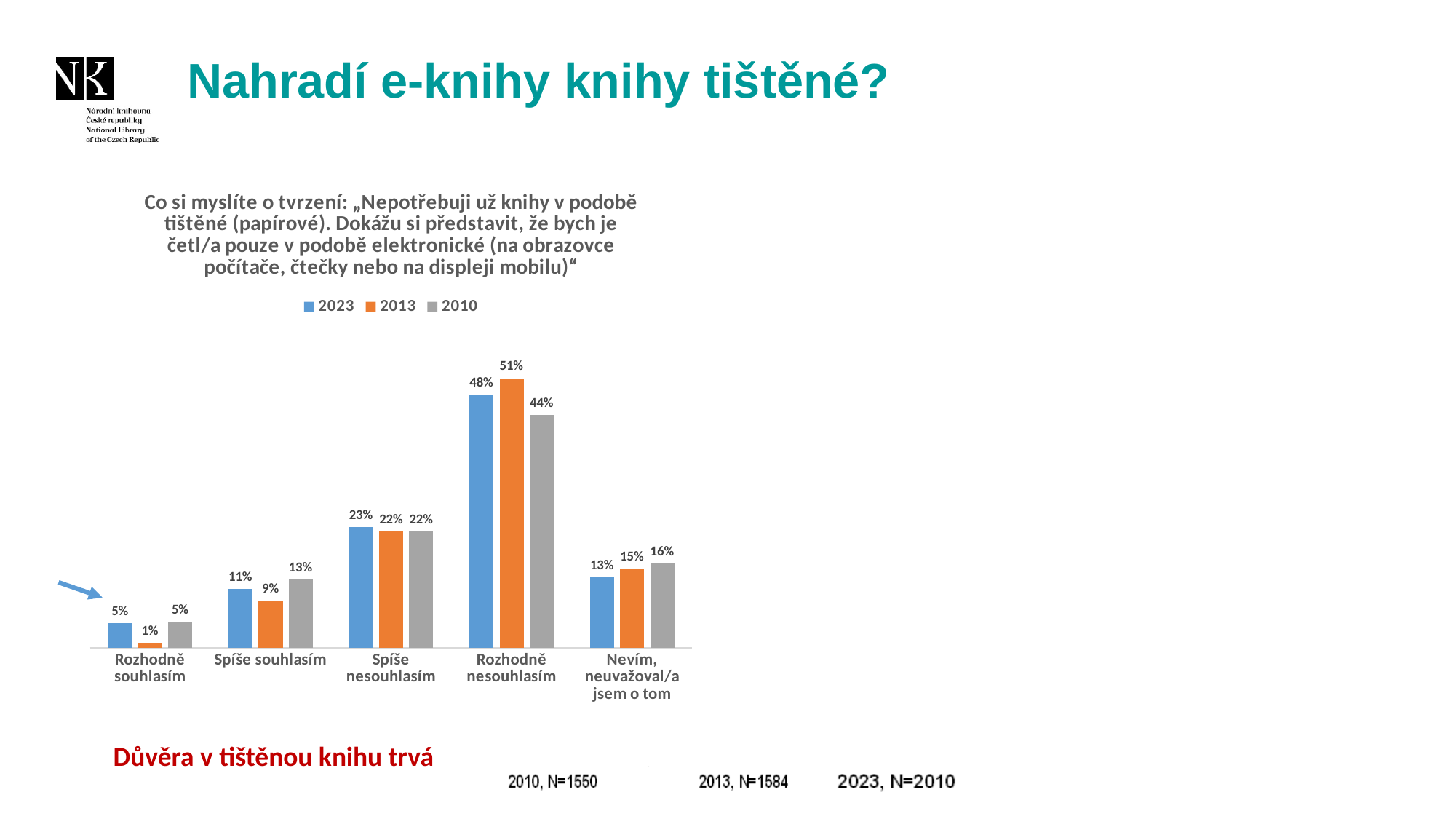
How many series does the legend list? 3 How many categories are shown on the x axis? 5 What is the value for 2010 in the "Nevím, neuvažoval/a jsem o tom" category? 16% What is the difference between the 2010 and 2013 values in the "Spíše souhlasím" category? 4% What is the difference between the 2013 and 2010 values in the "Rozhodně nesouhlasím" category? 7% What is the value for 2013 in the "Rozhodně souhlasím" category? 1% Which category has the lowest value for the 2023 series? Rozhodně souhlasím Which series is shown in orange in the legend? 2013 Which category has the highest value for the 2013 series? Rozhodně nesouhlasím In the "Spíše souhlasím" category, which series has the larger value, 2023 or 2013? 2023 What is the value for 2023 in the "Rozhodně nesouhlasím" category? 48% What kind of chart is shown on the slide? bar chart